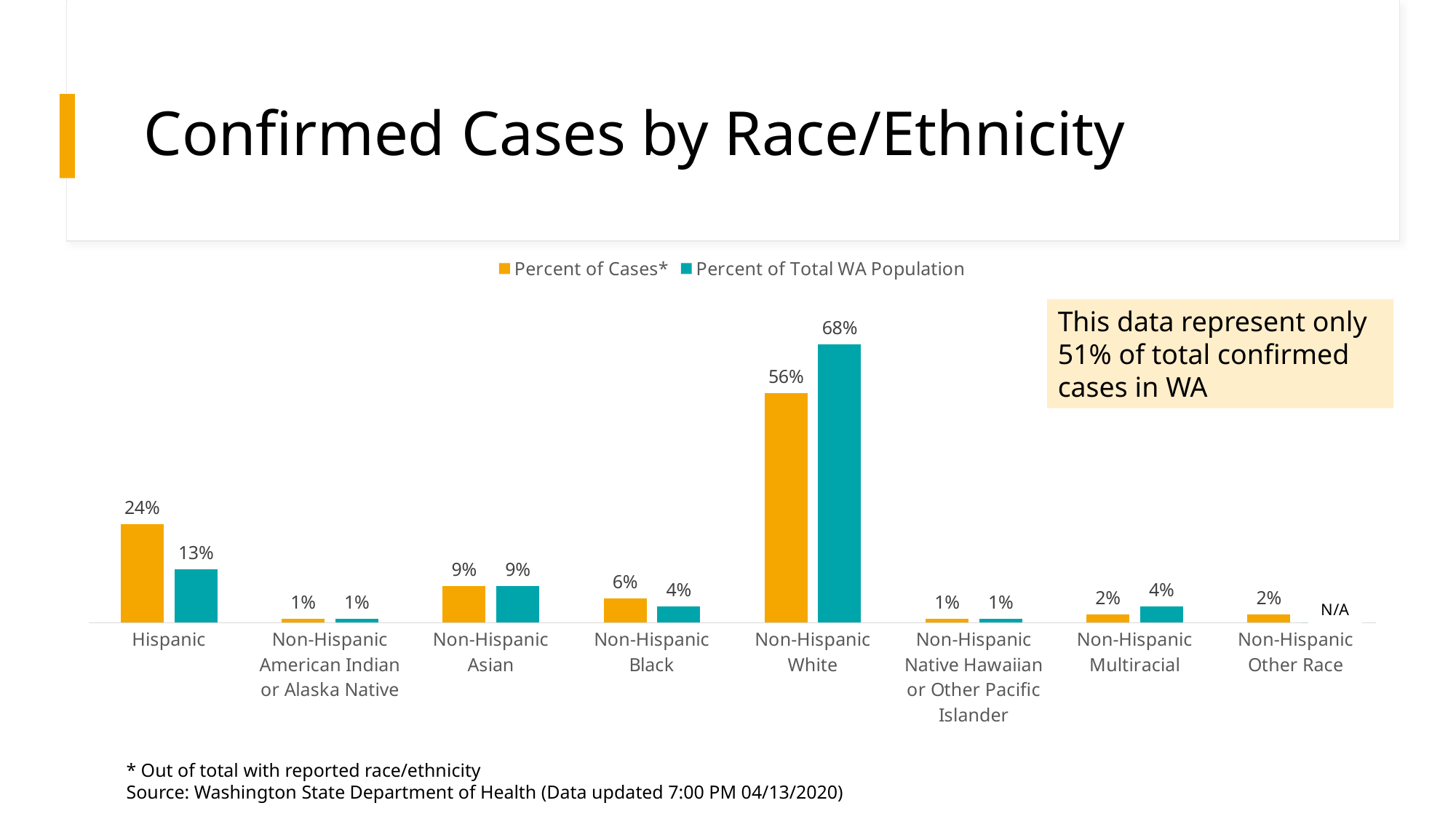
What is the difference between Percent of Total WA Population and Percent of Cases* for Non-Hispanic White? 12% What is the Percent of Total WA Population for Non-Hispanic White? 68% How many race/ethnicity categories are shown on the x axis? 8 Which is larger for Non-Hispanic Black: Percent of Cases* or Percent of Total WA Population? Percent of Cases* What kind of chart is shown on the slide? Bar chart What is shown for Percent of Total WA Population for Non-Hispanic Other Race? N/A What is the Percent of Total WA Population for Non-Hispanic Multiracial? 4% What is the difference between Percent of Cases* and Percent of Total WA Population for Hispanic? 11% How many series does the legend list? 2 Which category has the highest Percent of Cases*? Non-Hispanic White What is the Percent of Cases* for Hispanic? 24% What is the Percent of Cases* for Non-Hispanic Black? 6%